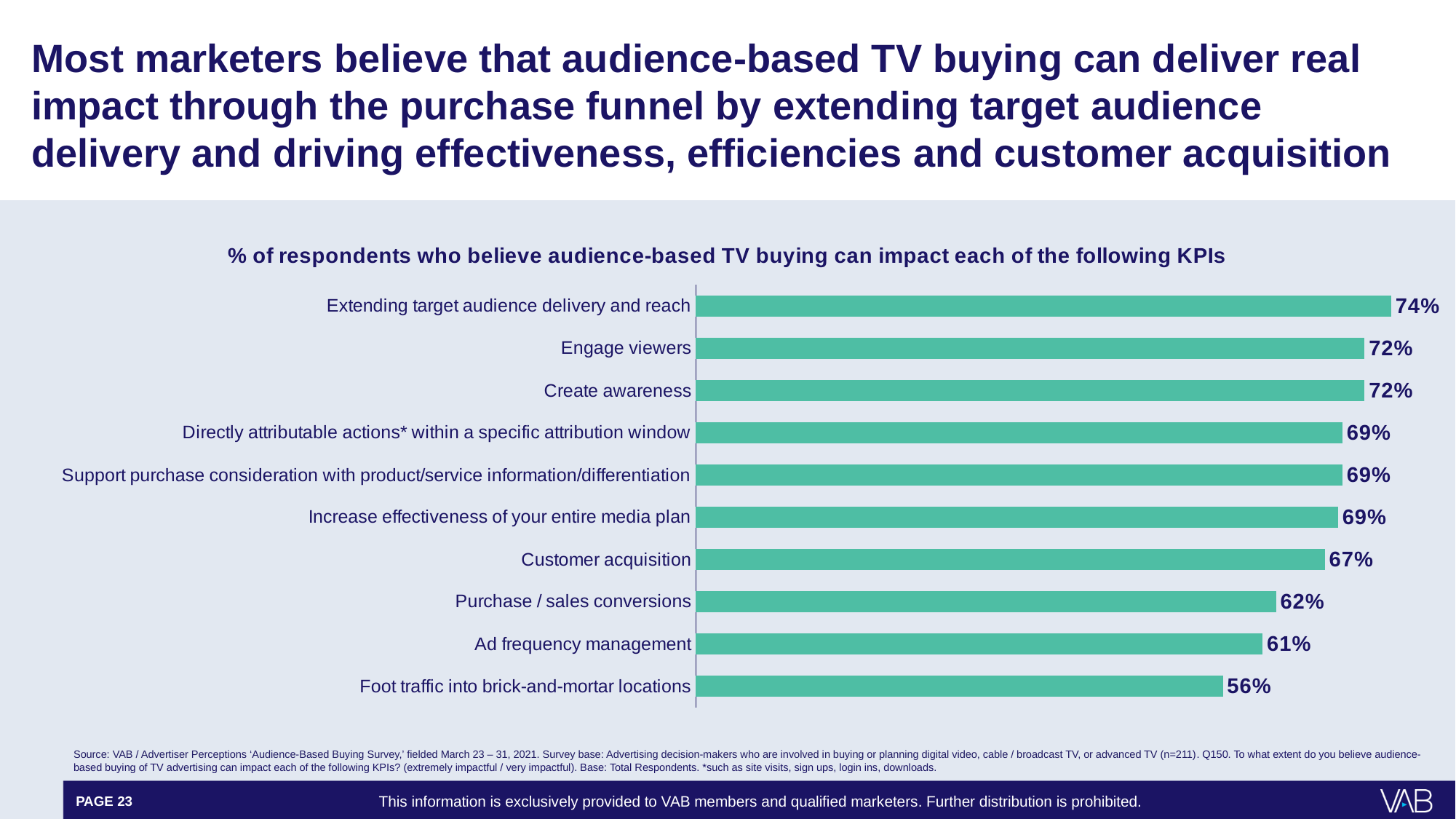
What is the difference between Customer acquisition and Purchase / sales conversions? 5 percentage points What is the value shown for Ad frequency management? 61% What type of chart is shown on the slide? Bar chart What is the difference in percentage points between Extending target audience delivery and reach and Foot traffic into brick-and-mortar locations? 18 percentage points Which KPI has the lowest percentage of respondents? Foot traffic into brick-and-mortar locations How many KPIs are shown in the chart? 10 Which is larger: the value for Engage viewers or the value for Customer acquisition? Engage viewers What percentage of respondents believe audience-based TV buying can impact extending target audience delivery and reach? 74% What is the value shown for Customer acquisition? 67% Which KPI has the highest percentage of respondents? Extending target audience delivery and reach What is the value shown for Purchase / sales conversions? 62% What is the title of the chart? % of respondents who believe audience-based TV buying can impact each of the following KPIs